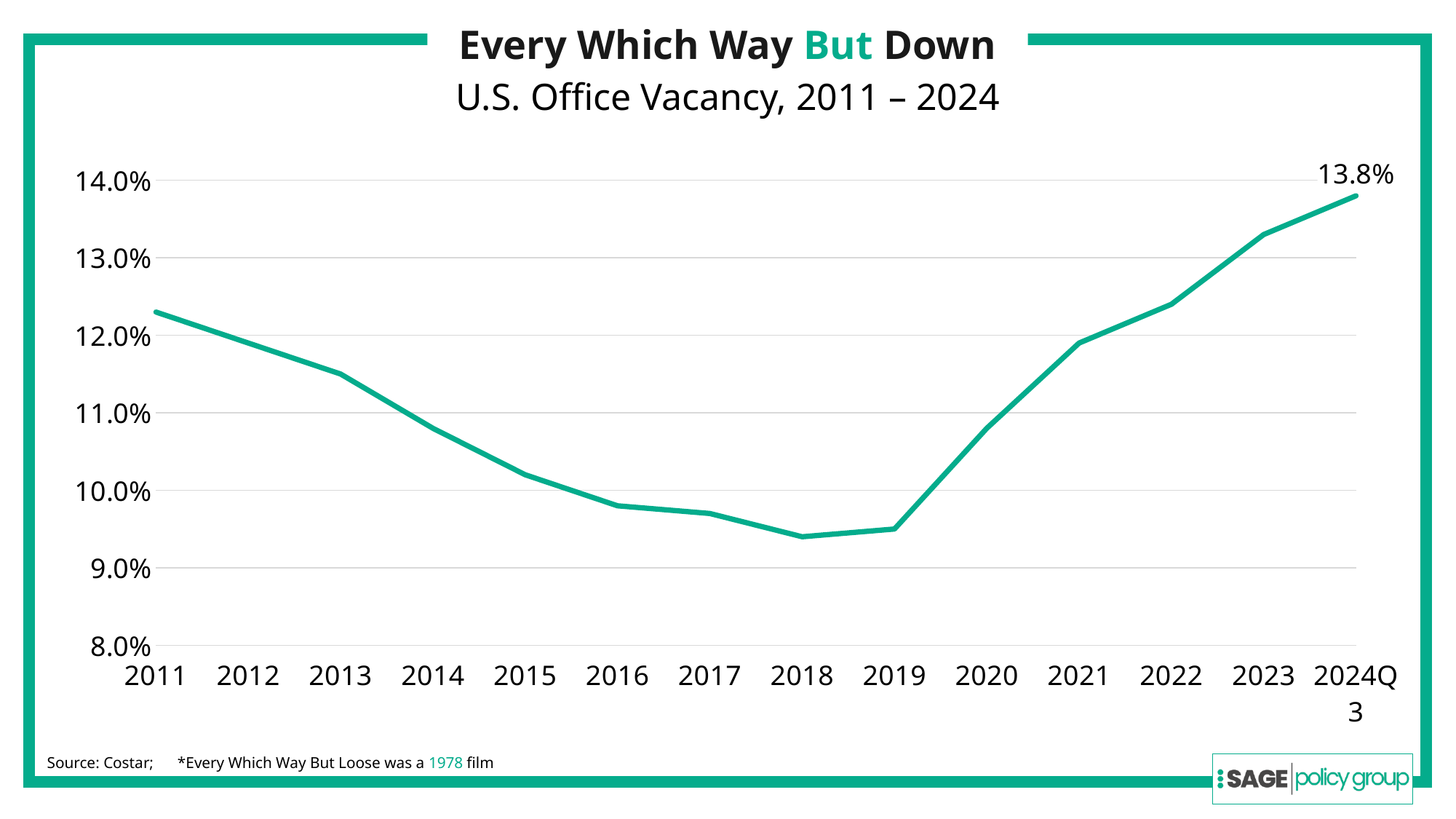
Is the office vacancy rate for 2011 greater or less than 12.0%? greater Is the office vacancy rate for 2013 greater or less than 11.0%? greater Which year has the higher office vacancy rate, 2011 or 2018? 2011 Does the office vacancy rate rise or fall from 2019 to 2024Q3? rise What is the U.S. office vacancy rate shown for 2024Q3? 13.8% What is the main title of the chart? Every Which Way But Down What type of chart is shown on the slide? line chart Which year has the highest office vacancy rate on the chart? 2024Q3 Is the office vacancy rate for 2023 greater or less than 13.0%? greater Does the office vacancy rate rise or fall from 2011 to 2018? fall How many data points are plotted on the line? 14